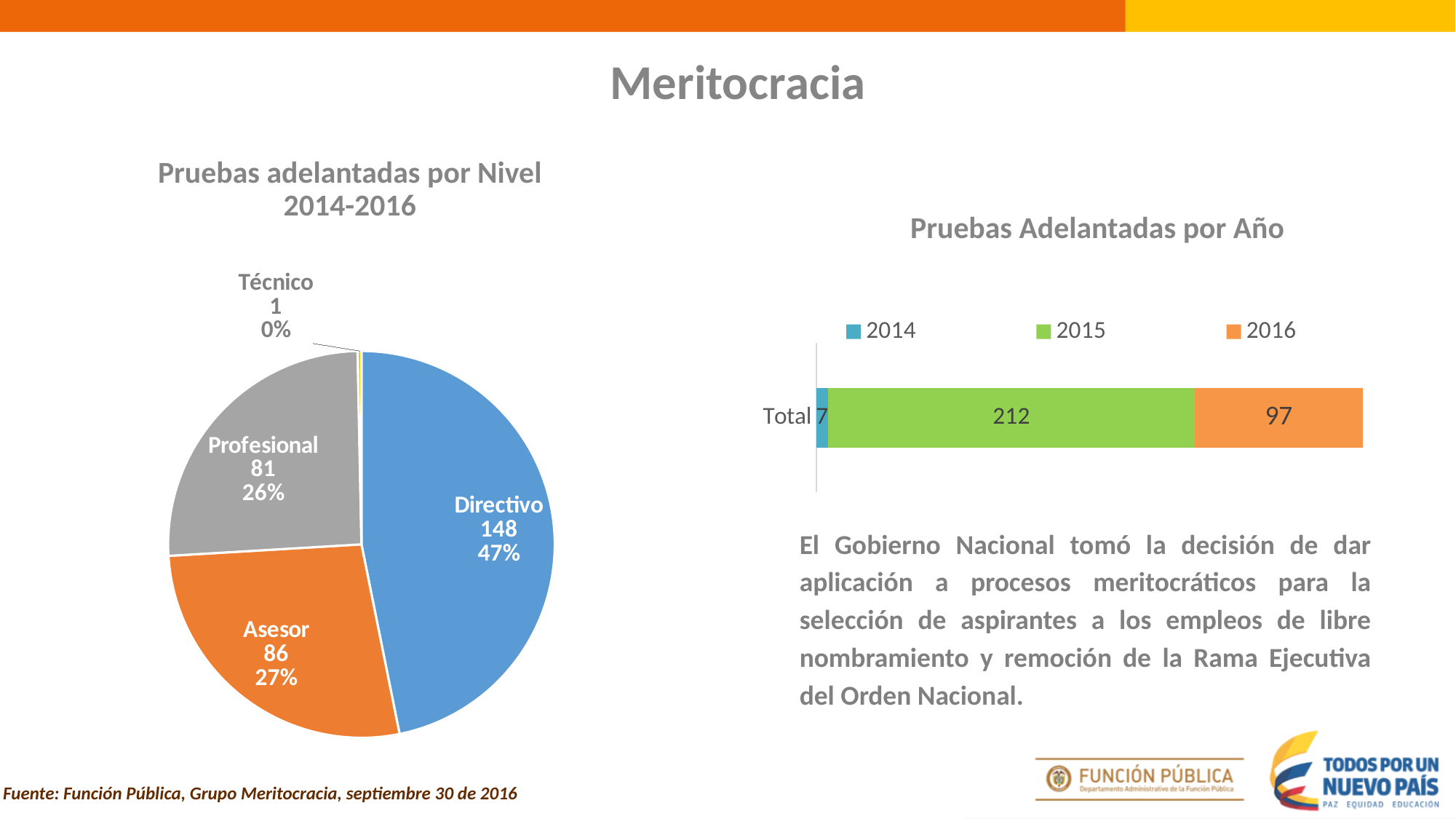
In the 'Pruebas adelantadas por Nivel 2014-2016' pie chart, what is the difference between the values for Asesor and Profesional? 5 In the 'Pruebas adelantadas por Nivel 2014-2016' pie chart, how many slices are there? 4 In the 'Pruebas adelantadas por Nivel 2014-2016' pie chart, what share of the pie does Asesor represent? 27% In the 'Pruebas adelantadas por Nivel 2014-2016' pie chart, which level has the smallest slice? Técnico In the 'Pruebas Adelantadas por Año' chart, how many series does the legend list? 3 In the 'Pruebas Adelantadas por Año' chart, what is the value for 2016? 97 What kind of chart is 'Pruebas Adelantadas por Año'? Stacked bar chart What kind of chart is 'Pruebas adelantadas por Nivel 2014-2016'? Pie chart In the 'Pruebas adelantadas por Nivel 2014-2016' pie chart, what is the value for Directivo? 148 In the 'Pruebas Adelantadas por Año' chart, what is the value for 2015? 212 In the 'Pruebas adelantadas por Nivel 2014-2016' pie chart, which level has the largest slice? Directivo In the 'Pruebas Adelantadas por Año' chart, what is the total of the stacked bar? 316